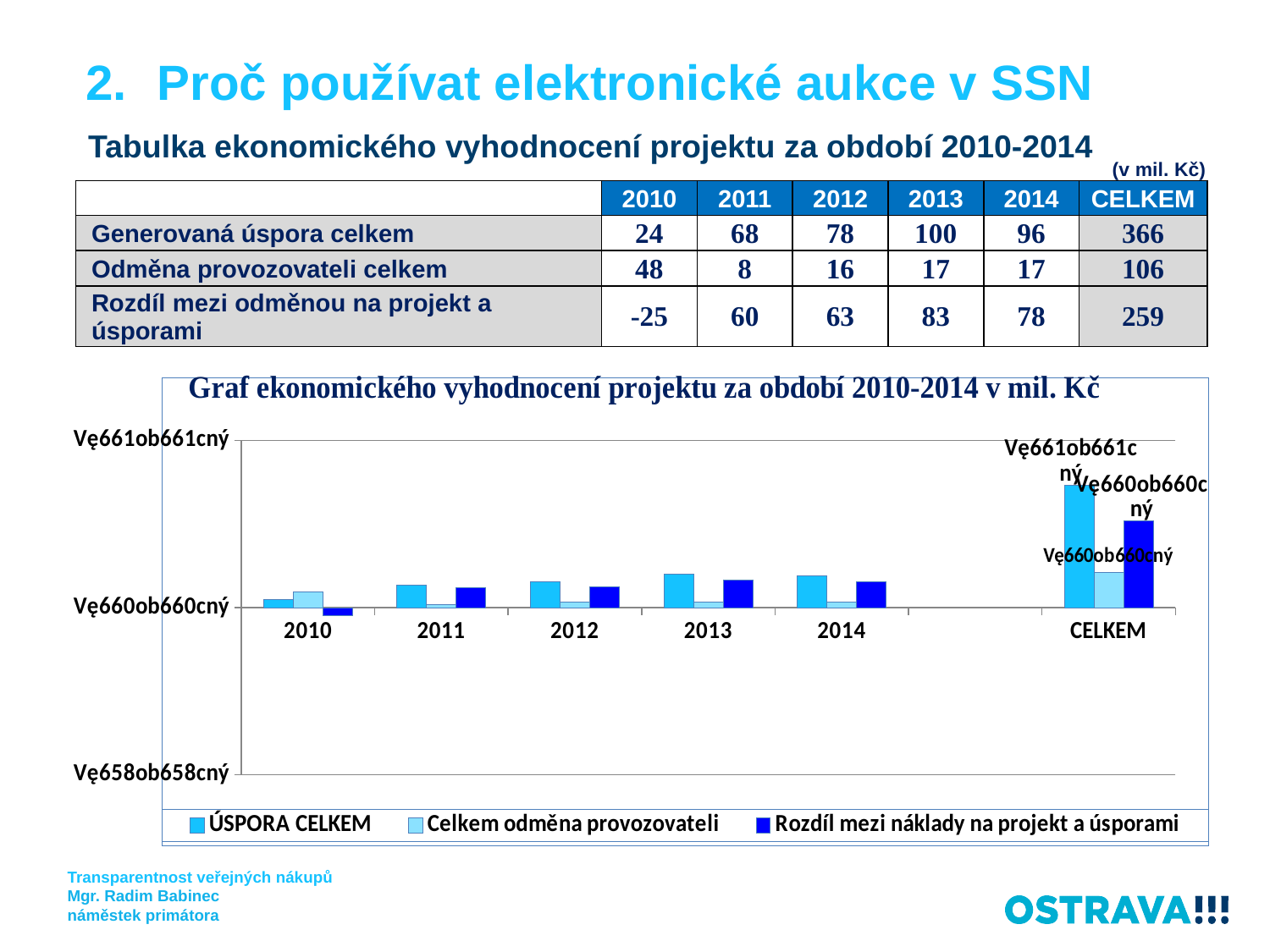
How many series does the chart legend list? 3 Among the years 2010 to 2014, which has the shortest ÚSPORA CELKEM bar? 2010 Does the ÚSPORA CELKEM series rise or fall from 2010 to 2013? rise Which series is shown in dark blue in the chart legend? Rozdíl mezi náklady na projekt a úsporami What kind of chart is shown on the slide? bar chart What is the title of the chart? Graf ekonomického vyhodnocení projektu za období 2010-2014 v mil. Kč Among the years 2010 to 2014, which has the tallest Celkem odměna provozovateli bar? 2010 In 2013, which is larger: ÚSPORA CELKEM or Celkem odměna provozovateli? ÚSPORA CELKEM How many categories are shown along the x axis of the chart? 6 In 2010, which is larger: ÚSPORA CELKEM or Celkem odměna provozovateli? Celkem odměna provozovateli Which category has the lowest Rozdíl mezi náklady na projekt a úsporami bar? 2010 Which category has the tallest ÚSPORA CELKEM bar? CELKEM